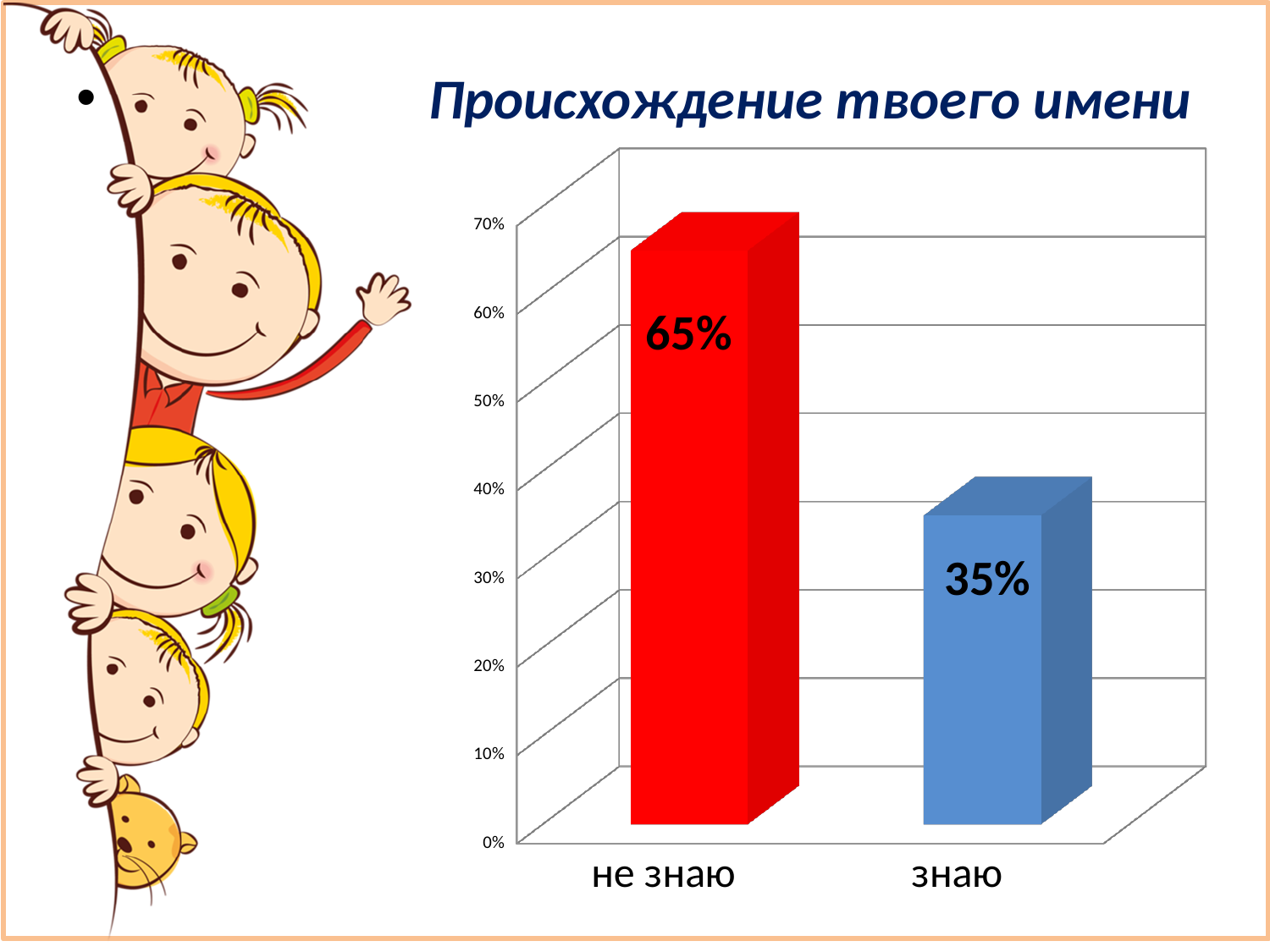
Which is larger, the value for "не знаю" or the value for "знаю"? не знаю Which category has the highest value? не знаю Is the value for "знаю" greater or less than 40%? less What is the title of the chart? Происхождение твоего имени What is the difference between the values for "не знаю" and "знаю"? 30% What colour is the bar for "знаю"? blue What is the value for "не знаю"? 65% What is the value for "знаю"? 35% How many categories are shown on the x axis? 2 Which category has the lowest value? знаю Is the value for "не знаю" greater or less than 60%? greater What kind of chart is shown on the slide? bar chart